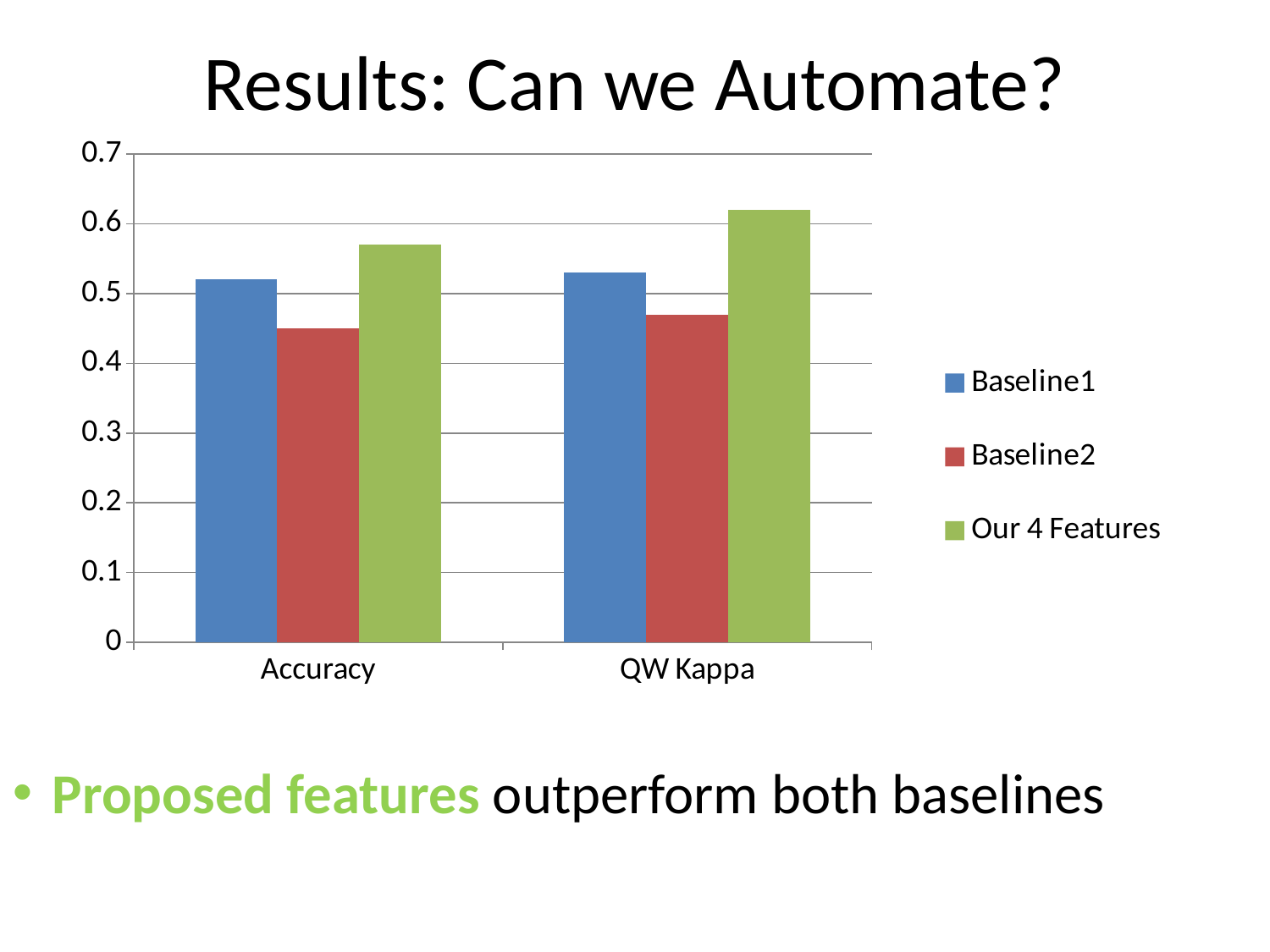
What colour are the bars for the Our 4 Features series? green Which series has the highest value for QW Kappa? Our 4 Features Is the value for Our 4 Features in QW Kappa greater or less than 0.6? greater How many categories are shown on the x axis? 2 Is the value for Baseline2 in QW Kappa greater or less than 0.5? less For QW Kappa, which is larger: Baseline1 or Baseline2? Baseline1 Which series has the lowest value for Accuracy? Baseline2 How many series does the legend list? 3 For Accuracy, which is larger: Baseline1 or Our 4 Features? Our 4 Features What kind of chart is shown on the slide? bar chart Is the value for Our 4 Features in Accuracy greater or less than 0.6? less